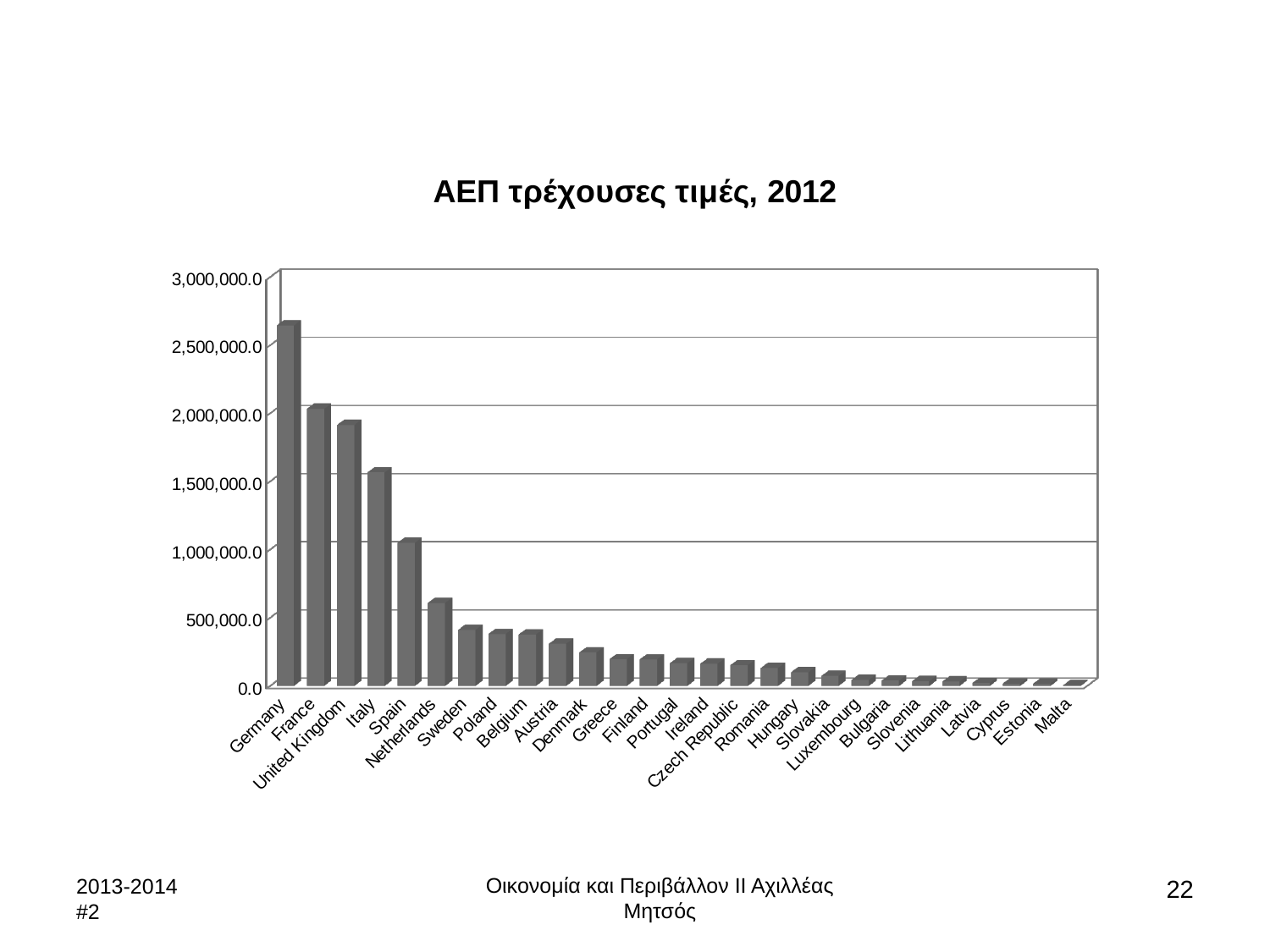
Is the value for Germany greater or less than 2,500,000.0? greater Which has the larger value, Spain or Poland? Spain What kind of chart is shown on the slide? bar chart Which country has the highest value in the chart? Germany Is the value for Sweden greater or less than 500,000.0? less Do the values rise or fall moving from left to right along the x axis? fall How many countries are shown on the x axis of the chart? 27 Is the value for United Kingdom greater or less than 2,000,000.0? less Which has the larger value, France or Italy? France What is the title of the chart? ΑΕΠ τρέχουσες τιμές, 2012 Which country has the lowest value in the chart? Malta